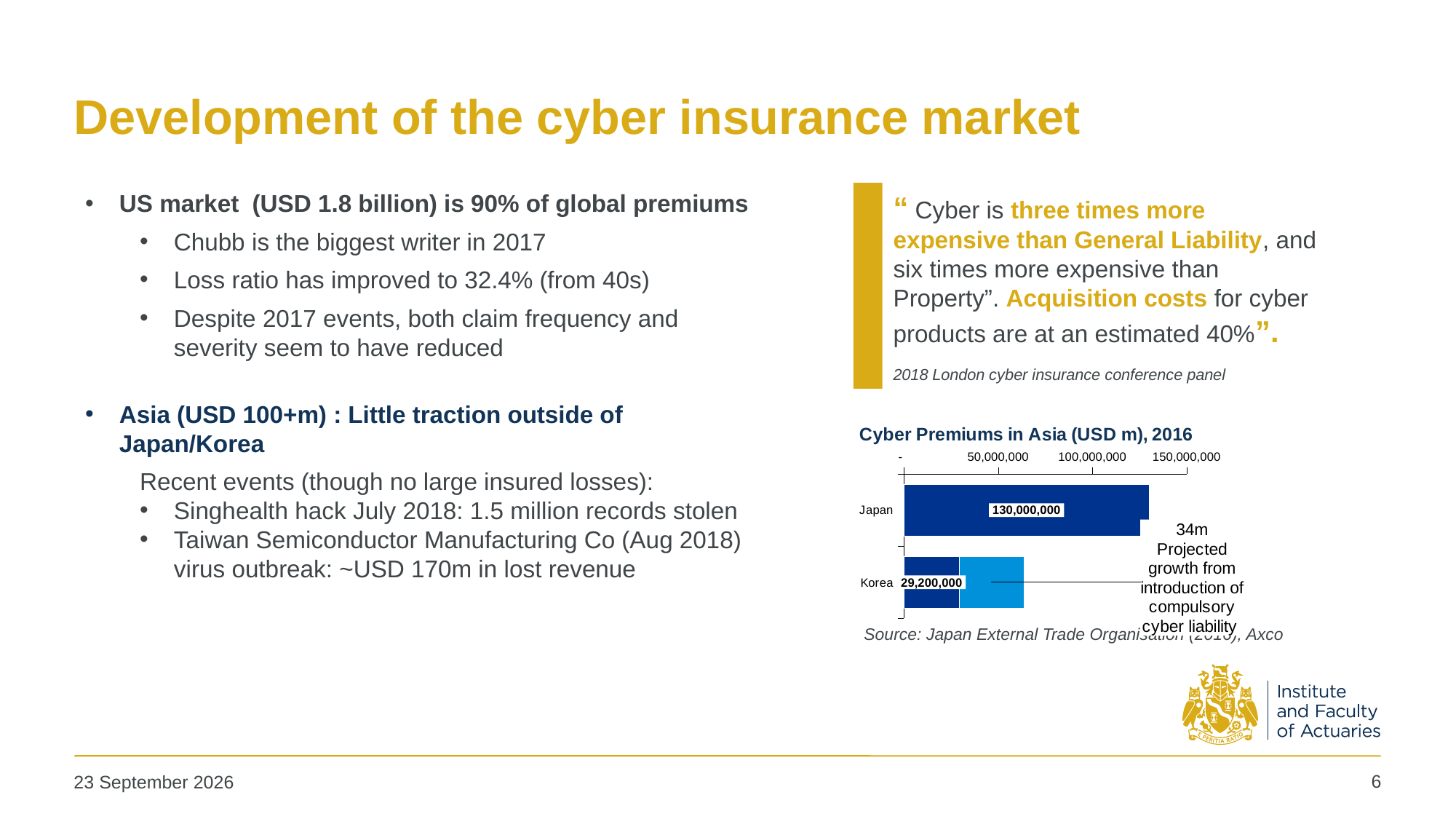
What is the difference between the cyber premiums for Japan and Korea? 100,800,000 What is the value for Japan in the Cyber Premiums in Asia chart? 130,000,000 What is the title of the chart on the slide? Cyber Premiums in Asia (USD m), 2016 Which country has the highest cyber premiums in the chart? Japan Which is larger, the cyber premiums for Japan or for Korea? Japan Is the value for Korea greater or less than 50,000,000? less How many countries are shown in the Cyber Premiums in Asia chart? 2 What kind of chart is used to show cyber premiums in Asia? Bar chart Is the value for Japan greater or less than 100,000,000? greater Which country has the lowest cyber premiums in the chart? Korea What is the value for Korea in the Cyber Premiums in Asia chart? 29,200,000 What does the light blue segment on the Korea bar represent? 34m projected growth from introduction of compulsory cyber liability